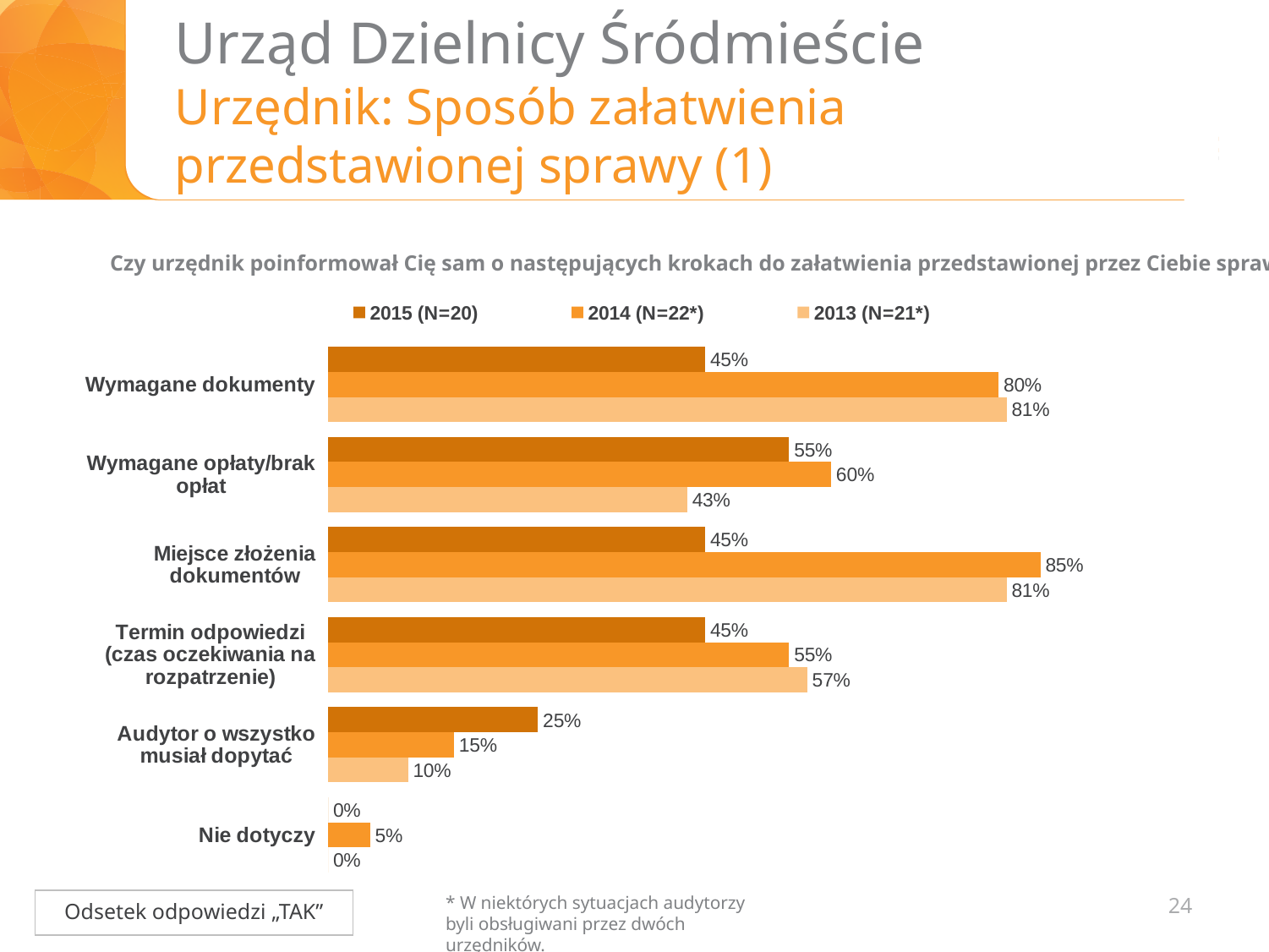
Which category has the lowest value in the 2013 (N=21*) series? Nie dotyczy Which category has the highest value in the 2014 (N=22*) series? Miejsce złożenia dokumentów What is the value for "Termin odpowiedzi (czas oczekiwania na rozpatrzenie)" in the 2013 (N=21*) series? 57% How many series does the legend list? 3 What is the value for "Miejsce złożenia dokumentów" in the 2014 (N=22*) series? 85% What is the difference between the 2014 (N=22*) and 2015 (N=20) values for "Wymagane dokumenty"? 35% What kind of chart is shown on the slide? bar chart What is the value for "Wymagane dokumenty" in the 2015 (N=20) series? 45% For "Audytor o wszystko musiał dopytać", which series has the larger value: 2015 (N=20) or 2013 (N=21*)? 2015 (N=20) What is the value for "Nie dotyczy" in the 2014 (N=22*) series? 5% What is the value for "Wymagane opłaty/brak opłat" in the 2013 (N=21*) series? 43% How many categories are shown on the chart? 6